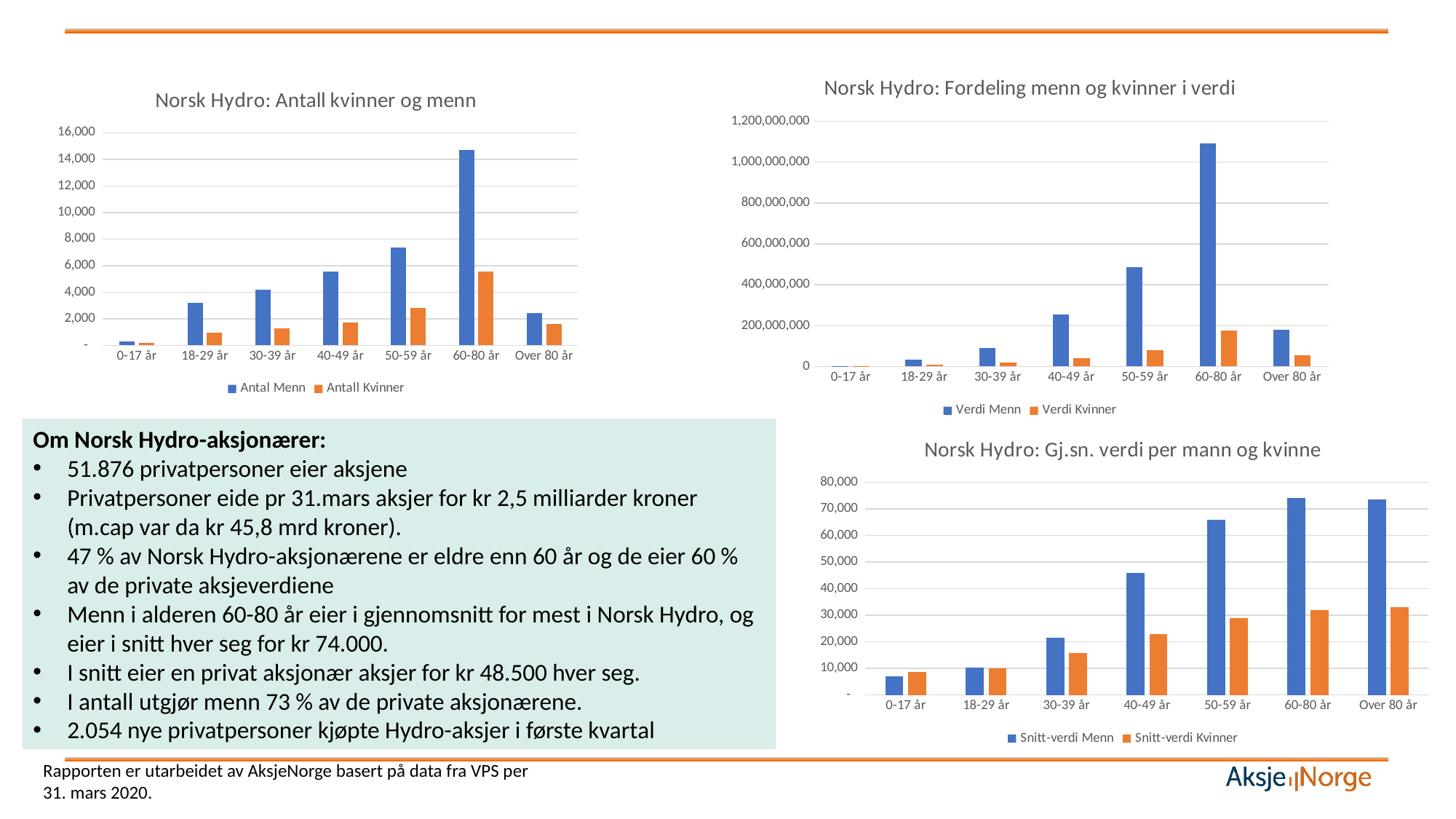
What type of chart is "Norsk Hydro: Antall kvinner og menn"? bar chart In the chart "Norsk Hydro: Fordeling menn og kvinner i verdi", which age group has the highest value for Verdi Menn? 60-80 år In the chart "Norsk Hydro: Antall kvinner og menn", which age group has the highest value for Antal Menn? 60-80 år In the chart "Norsk Hydro: Antall kvinner og menn", how many age categories are shown on the x axis? 7 How many series does the legend of the chart "Norsk Hydro: Fordeling menn og kvinner i verdi" list? 2 In the chart "Norsk Hydro: Antall kvinner og menn", is the value for Antall Kvinner in the 60-80 år group greater or less than 4,000? greater In the chart "Norsk Hydro: Gj.sn. verdi per mann og kvinne", is the value for Snitt-verdi Menn in the 50-59 år group greater or less than 60,000? greater In the chart "Norsk Hydro: Antall kvinner og menn", which age group has the lowest value for Antall Kvinner? 0-17 år In the chart "Norsk Hydro: Antall kvinner og menn", is the value for Antal Menn in the 60-80 år group greater or less than 14,000? greater In the chart "Norsk Hydro: Gj.sn. verdi per mann og kvinne", do the values for Snitt-verdi Kvinner rise or fall from 0-17 år to Over 80 år? rise In the chart "Norsk Hydro: Gj.sn. verdi per mann og kvinne", which series is shown in orange? Snitt-verdi Kvinner